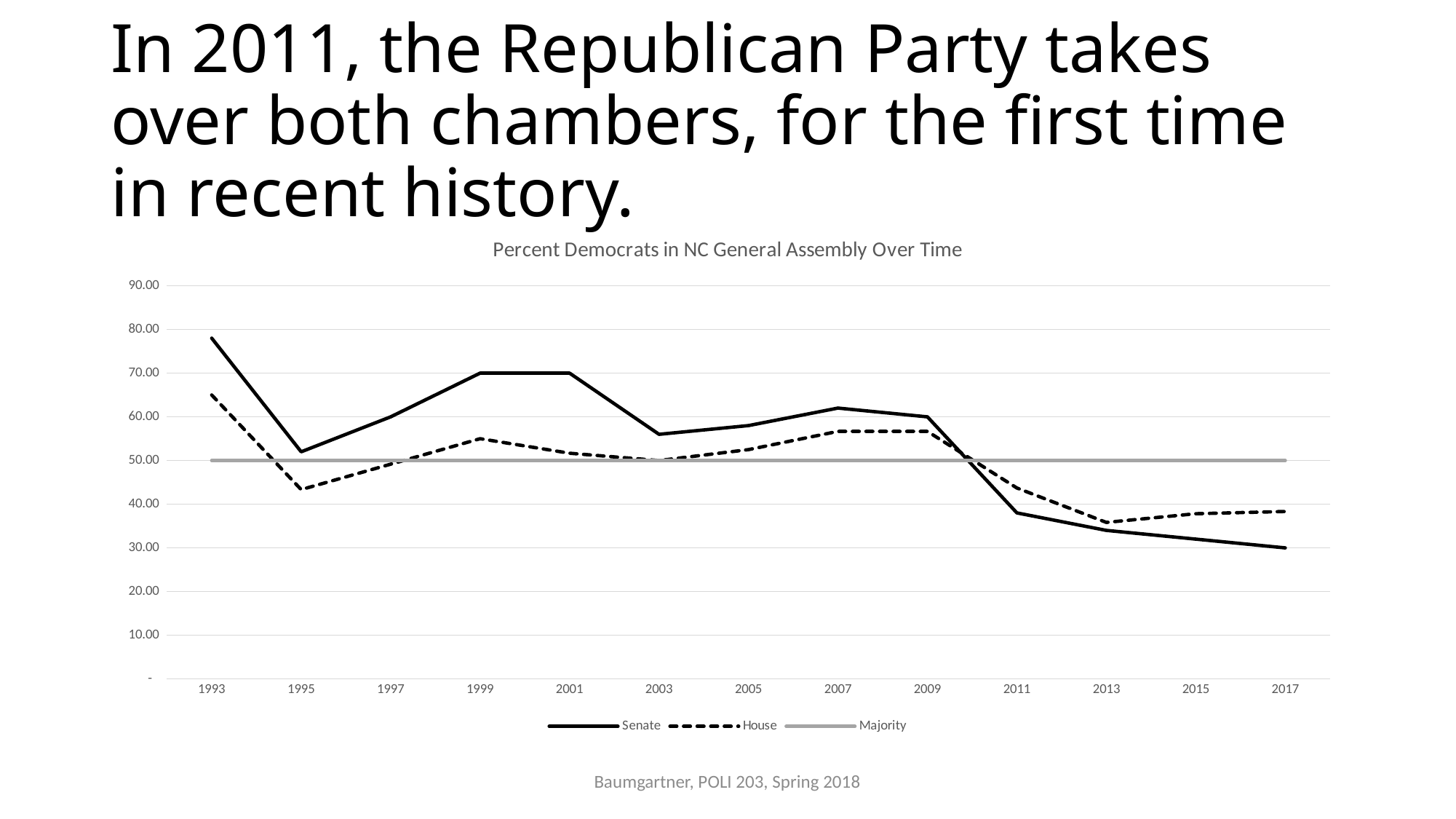
In which year is the Senate value lowest? 2017 Is the House value in 1995 greater or less than 50? less How many series does the legend list? 3 What kind of chart is shown on the slide? line chart How many years are plotted along the x axis? 13 What is the Senate value in 2017? 30.00 Is the Senate value in 1993 greater or less than 70? greater In which year is the Senate value highest? 1993 What value does the Majority line sit at across all years? 50.00 Does the Senate line rise or fall from 2009 to 2017? fall What is the title of the chart? Percent Democrats in NC General Assembly Over Time In 2017, which is larger, the Senate value or the House value? House